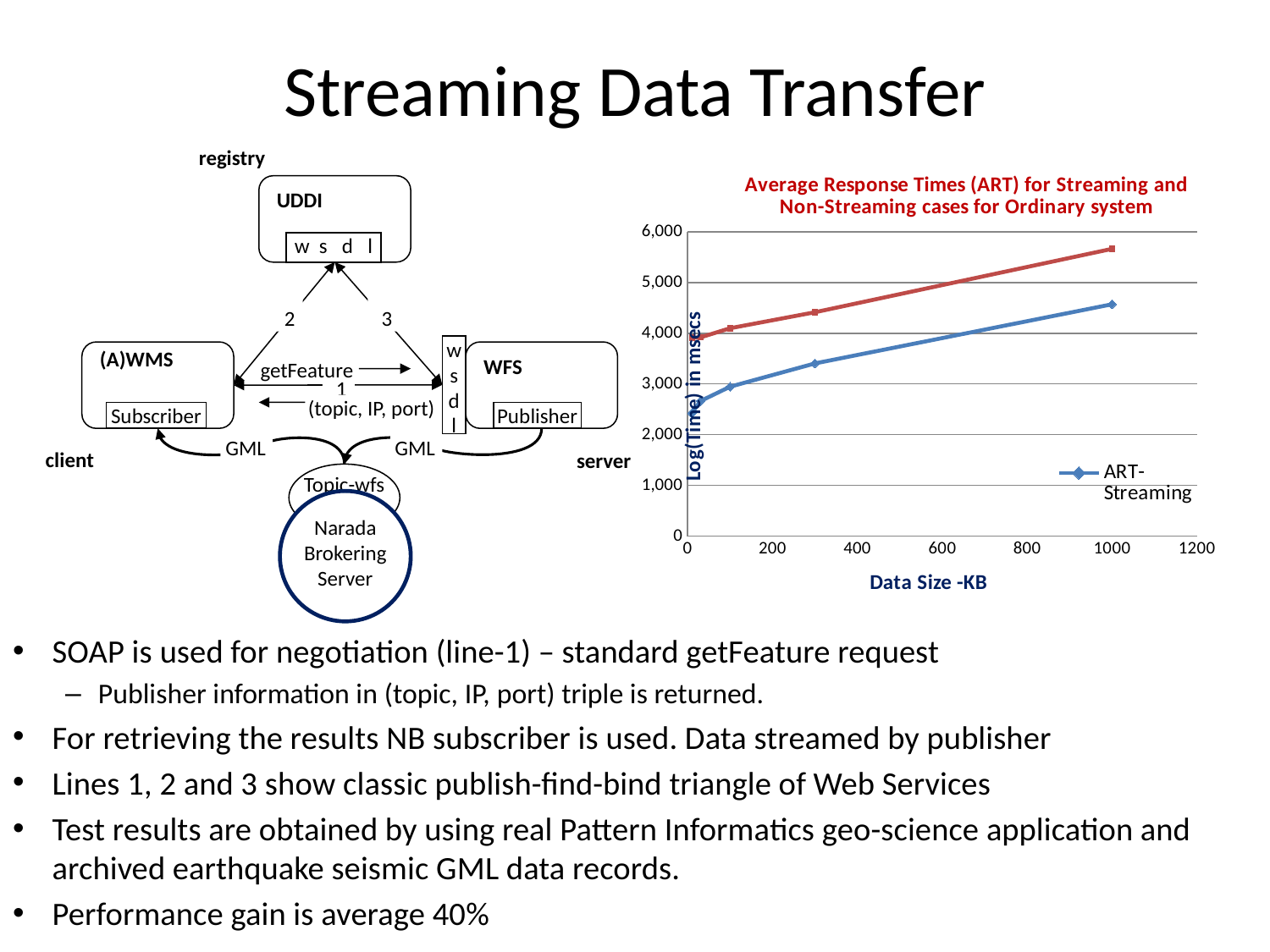
At a data size of 1000 KB, which line has the higher value, the red line or the blue ART-Streaming line? the red line Does the ART-Streaming line rise or fall as data size increases? rise Is the value of the red (upper) line at a data size of 1000 KB greater or less than 5,000? greater Is the ART-Streaming value at a data size of 1000 KB greater or less than 4,000? greater What is the label of the x axis of the chart? Data Size -KB Is the ART-Streaming value at a data size of 1000 KB greater or less than 5,000? less What is the title of the chart on the slide? Average Response Times (ART) for Streaming and Non-Streaming cases for Ordinary system How many lines are plotted on the chart? 2 Which series name is shown in the chart's legend? ART-Streaming What kind of chart is shown on the slide? line chart